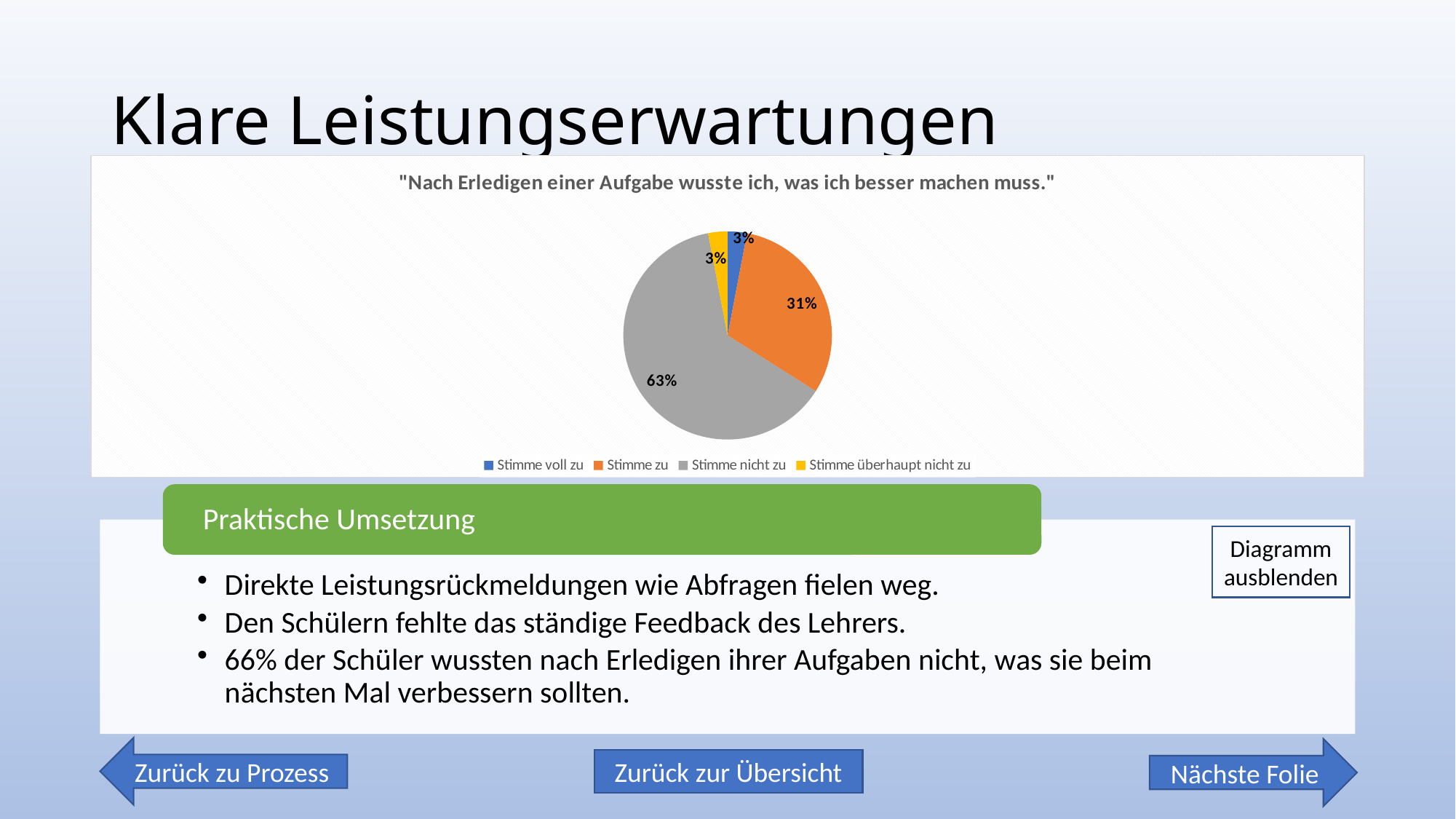
What colour is the "Stimme nicht zu" slice? gray Which category has the largest slice of the pie? Stimme nicht zu What is the difference between the shares of "Stimme nicht zu" and "Stimme zu"? 32% What share of the pie does "Stimme überhaupt nicht zu" have? 3% What share of the pie does "Stimme nicht zu" have? 63% What is the title of the pie chart? "Nach Erledigen einer Aufgabe wusste ich, was ich besser machen muss." Which is larger, the share of "Stimme zu" or the share of "Stimme nicht zu"? Stimme nicht zu What share of the pie does "Stimme voll zu" have? 3% What kind of chart is shown on the slide? pie chart How many entries does the legend list? 4 How many slices does the pie chart have? 4